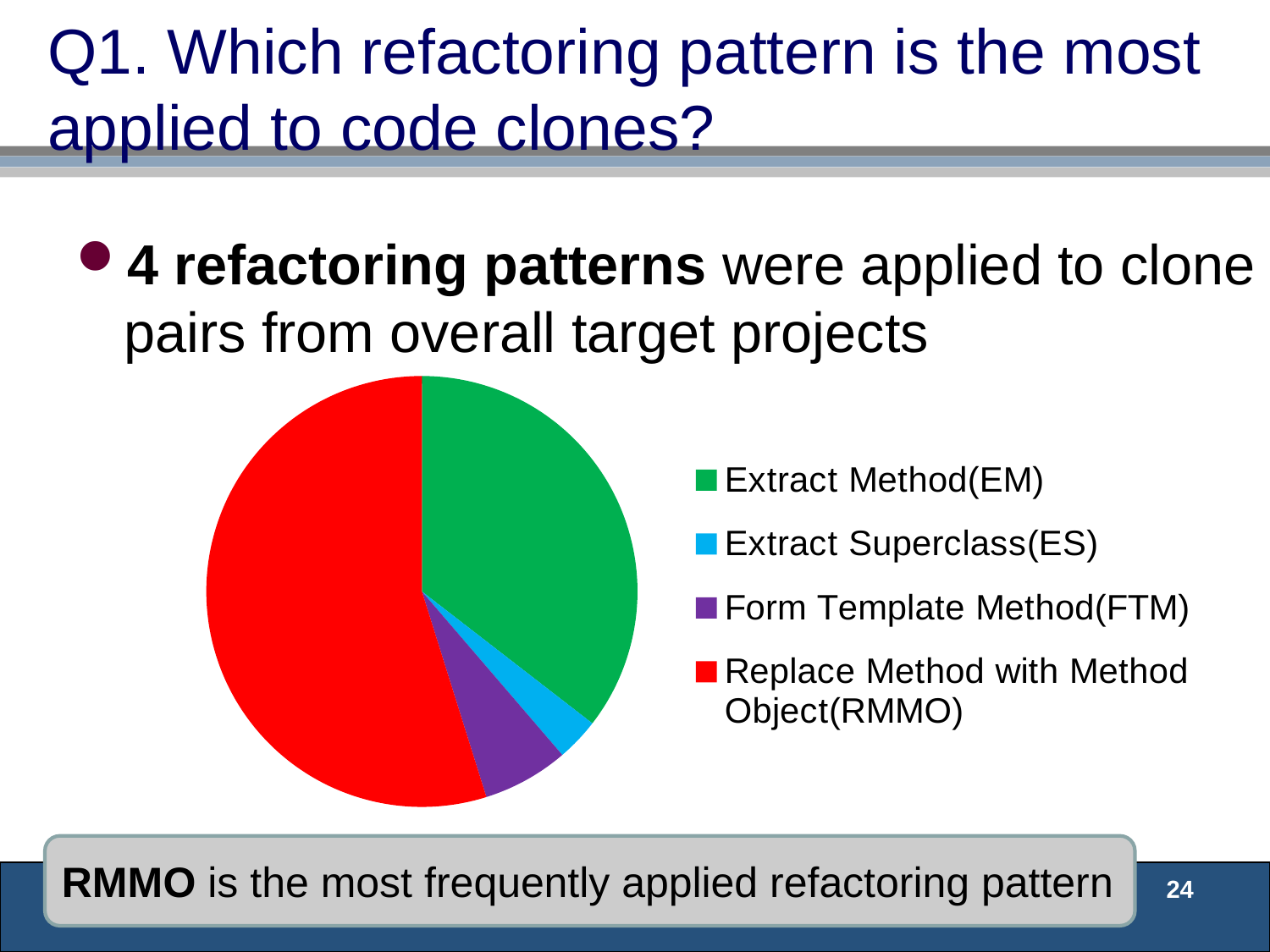
How many entries does the legend of the pie chart list? 4 Which slice is larger in the pie chart: Extract Method(EM) or Replace Method with Method Object(RMMO)? Replace Method with Method Object(RMMO) How many slices does the pie chart have? 4 Which refactoring pattern is shown in red in the pie chart? Replace Method with Method Object(RMMO) Which slice is larger in the pie chart: Extract Method(EM) or Form Template Method(FTM)? Extract Method(EM) What kind of chart is shown on the slide? pie chart What colour is the Extract Method(EM) slice in the pie chart? green Which refactoring pattern has the largest slice in the pie chart? Replace Method with Method Object(RMMO) Which slice is larger in the pie chart: Form Template Method(FTM) or Replace Method with Method Object(RMMO)? Replace Method with Method Object(RMMO) Which refactoring pattern has the smallest slice in the pie chart? Extract Superclass(ES)